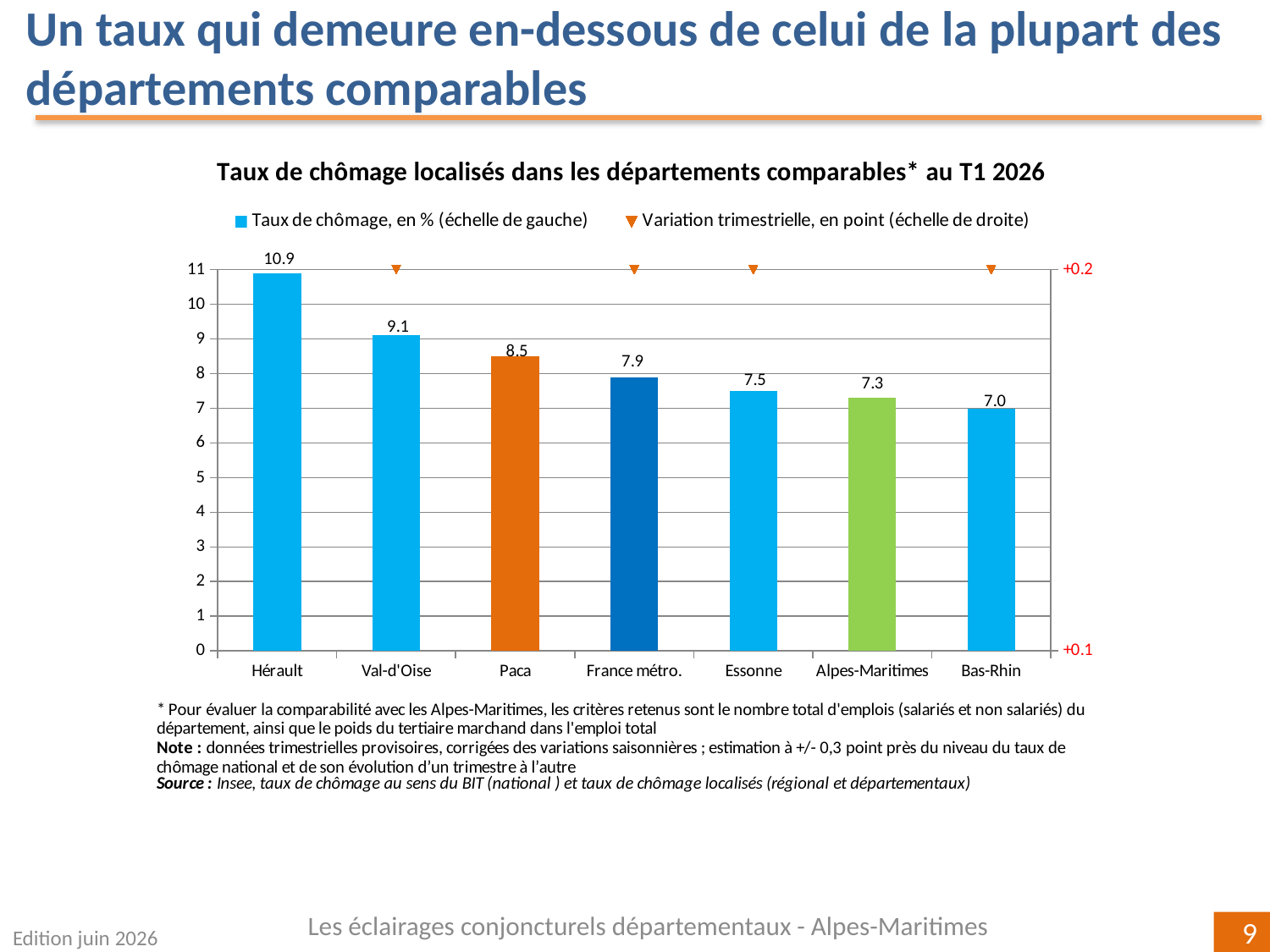
Which category has the lowest unemployment rate on the chart? Bas-Rhin Which has a higher unemployment rate, Paca or France métro.? Paca What is the unemployment rate (taux de chômage) shown for Hérault? 10.9 What kind of chart is used to show the unemployment rates? bar chart Which department has the highest unemployment rate on the chart? Hérault What is the difference between the unemployment rates of Hérault and Bas-Rhin? 3.9 What is the unemployment rate shown for France métro.? 7.9 What is the difference between the unemployment rates of Val-d'Oise and Paca? 0.6 How many categories are shown on the x axis of the chart? 7 How many series does the chart legend list? 2 Is the unemployment rate for Essonne greater or less than 8? less What is the unemployment rate shown for Alpes-Maritimes? 7.3